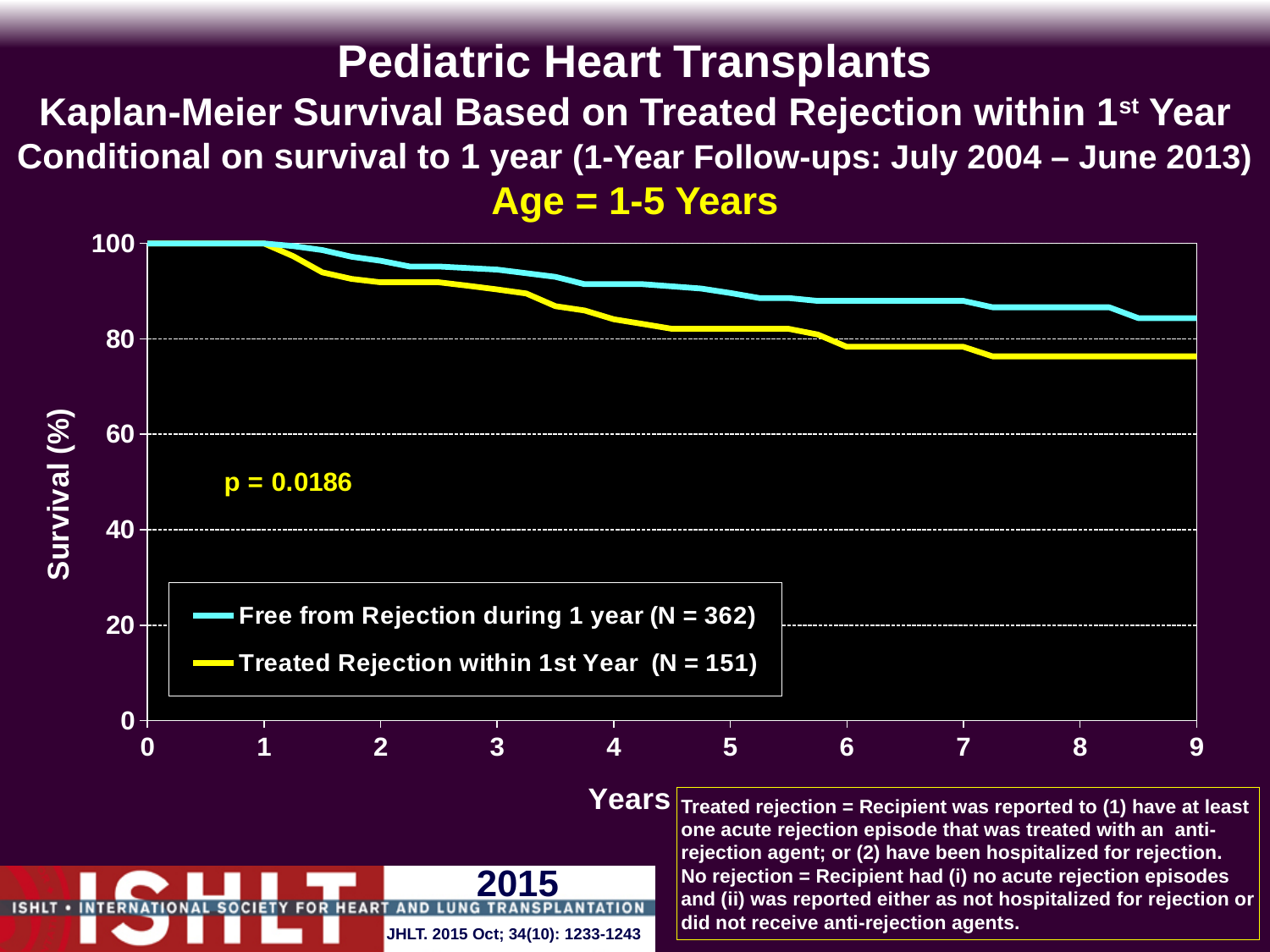
What kind of chart is shown on the slide? line chart What is the last year labelled on the x axis? 9 Which series is shown in yellow? Treated Rejection within 1st Year (N = 151) Is the survival value for the Treated Rejection group at year 9 greater or less than 80? less At year 9, which group has the higher survival: Free from Rejection or Treated Rejection? Free from Rejection Is the survival value for the Treated Rejection group at year 3 greater or less than 80? greater Is the survival value for the Free from Rejection group at year 6 greater or less than 100? less What p-value is printed on the chart? p = 0.0186 What is the maximum value shown on the Survival (%) axis? 100 Do the survival curves rise or fall as years increase? fall How many series does the legend list? 2